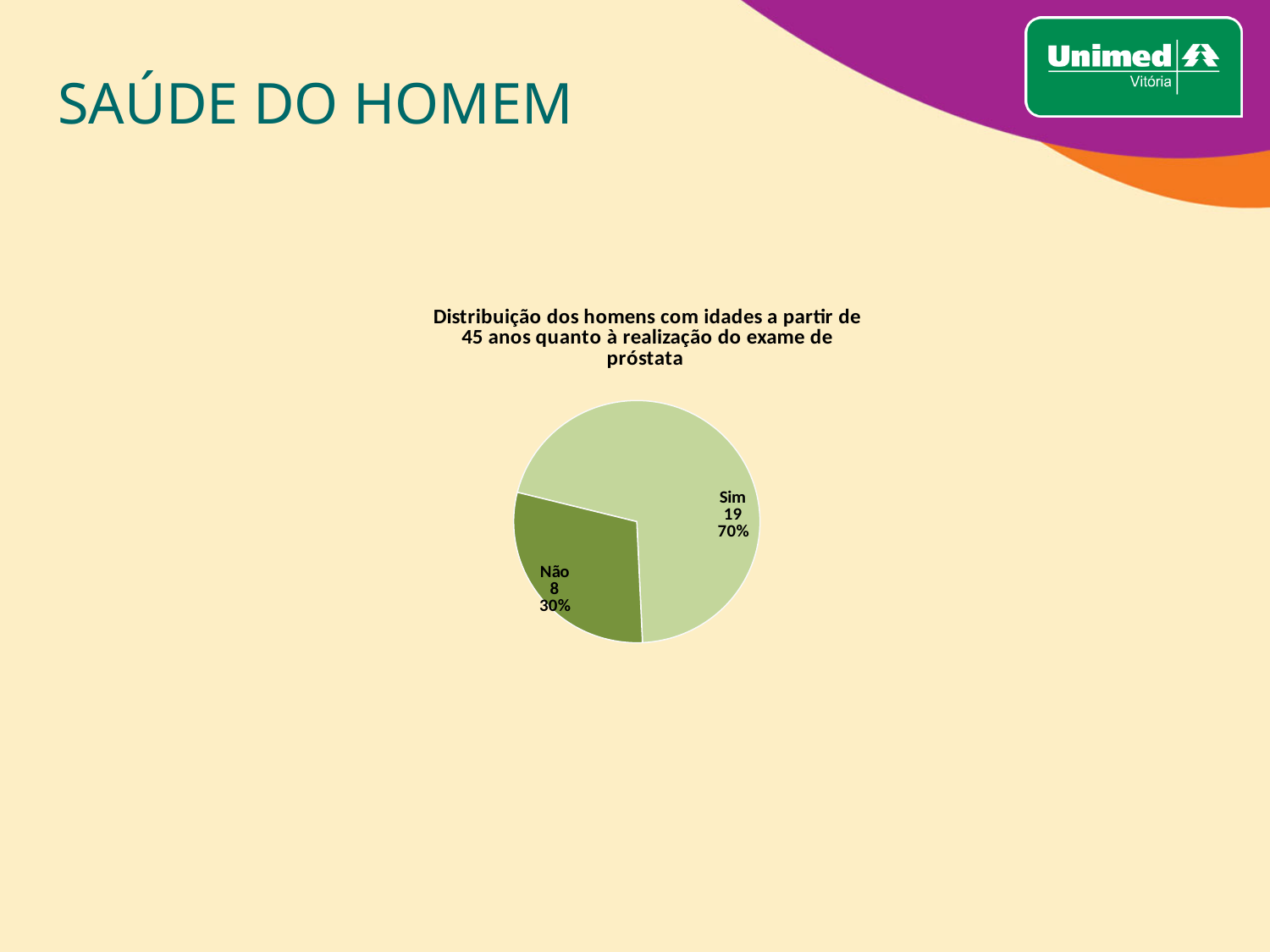
How many slices does the pie chart have? 2 What percentage share does the "Não" slice represent? 30% Which slice is the smallest? Não What is the title of the chart? Distribuição dos homens com idades a partir de 45 anos quanto à realização do exame de próstata What is the count shown for the "Sim" slice? 19 What is the count shown for the "Não" slice? 8 What kind of chart is shown on the slide? pie chart Which slice is the largest? Sim Which is larger, the "Sim" slice or the "Não" slice? Sim What is the difference in count between the "Sim" and "Não" slices? 11 What is the total count across both slices of the pie chart? 27 What percentage share does the "Sim" slice represent? 70%